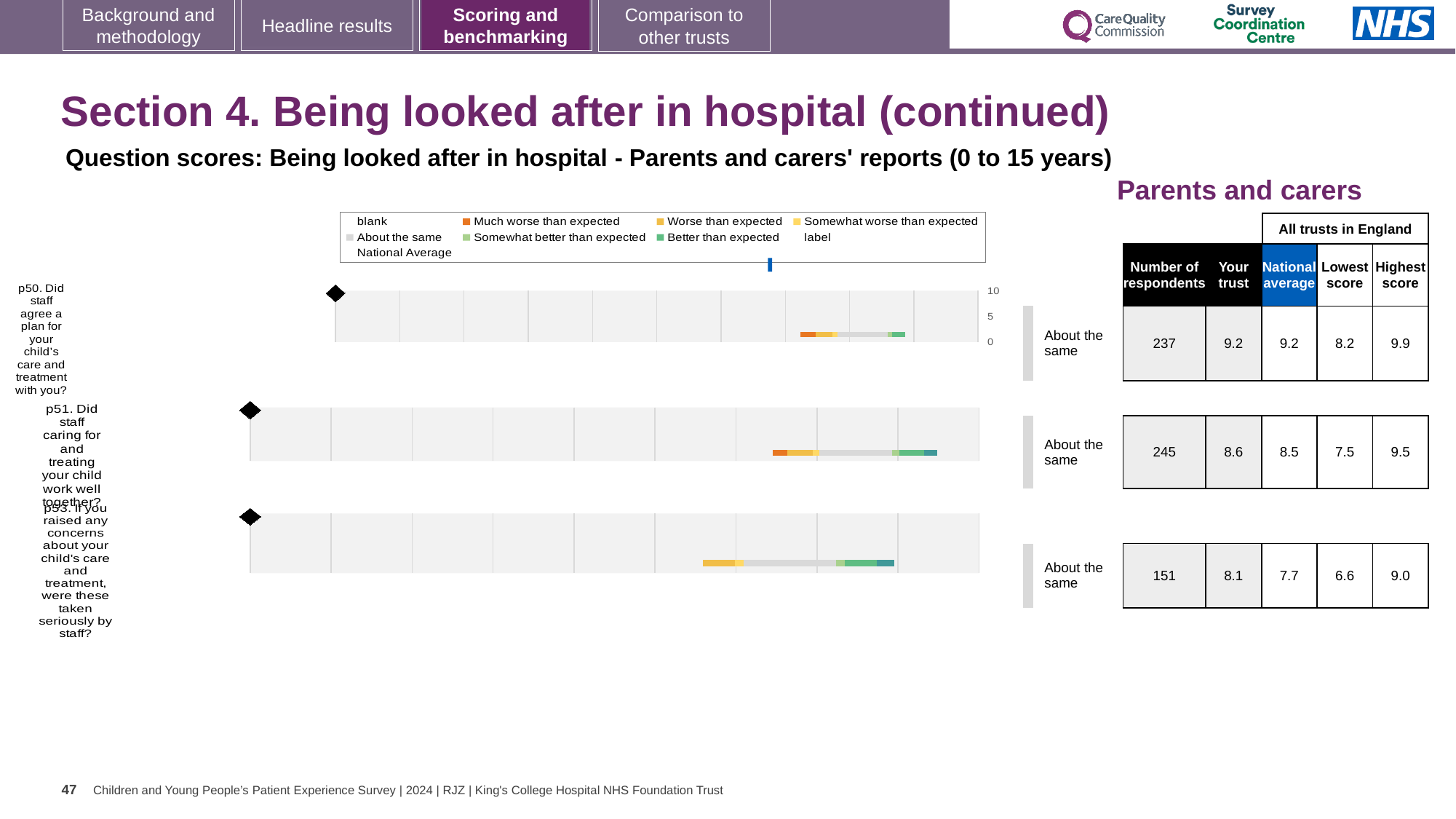
Which of the three questions has the lowest number of respondents in the table? p53 What benchmark category is shown beside the chart for p51? About the same Which of the three questions has the highest 'Your trust' score in the table? p50 For p53, how much higher is the 'Your trust' score than the national average in the table? 0.4 How many questions have a benchmarking chart on this slide? 3 What colour does the legend use for 'Much worse than expected'? orange In the table next to the charts, what is the national average for p53 (If you raised any concerns about your child's care and treatment, were these taken seriously by staff)? 7.7 In the table next to the charts, what is the 'Your trust' score for p51 (Did staff caring for and treating your child work well together)? 8.6 In the table next to the charts, what is the highest score across all trusts in England for p50? 9.9 In the table next to the charts, what is the number of respondents for p50 (Did staff agree a plan for your child's care and treatment with you)? 237 Which has the larger 'Your trust' score in the table, p51 or p53? p51 What kind of chart is used to show the benchmarking for p50 (Did staff agree a plan for your child's care and treatment with you)? bar chart